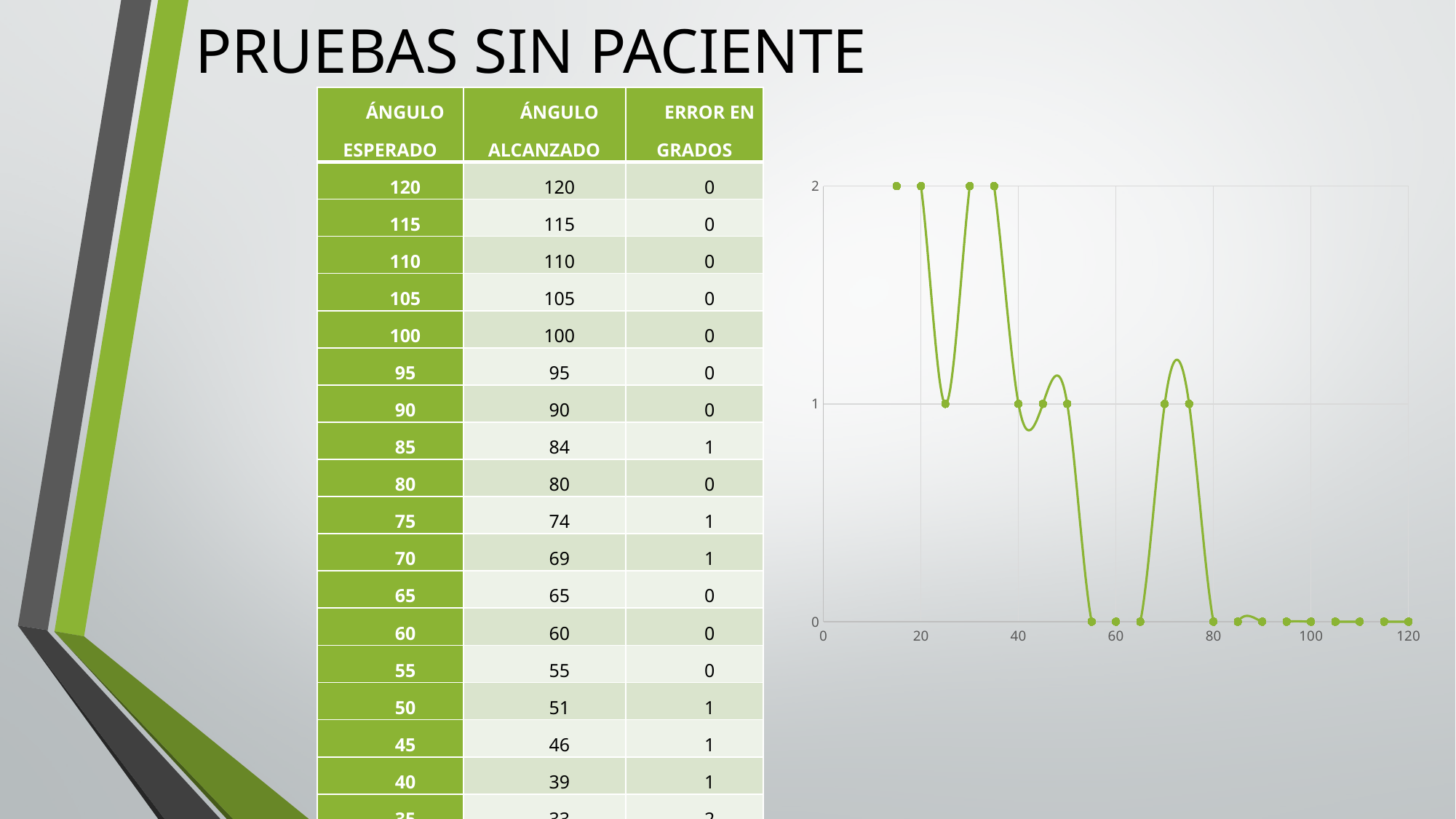
In the chart, what is the y value of the point at x = 60? 0 In the chart, what is the y value of the point at x = 25? 1 In the chart, which point has the larger y value: the one at x = 20 or the one at x = 40? x = 20 Do the plotted y values in the chart generally rise or fall as x increases from 15 to 120? fall What kind of chart is shown on the right of the slide? line chart What is the highest y value reached by any point in the chart? 2 In the chart, what is the y value of the point at x = 70? 1 In the chart, what is the y value of the point at x = 120? 0 In the chart, is the y value at x = 50 greater or less than 2? less What is the maximum value shown on the chart's x axis? 120 What is the lowest y value reached by any point in the chart? 0 In the chart, what is the difference between the y value at x = 30 and the y value at x = 45? 1